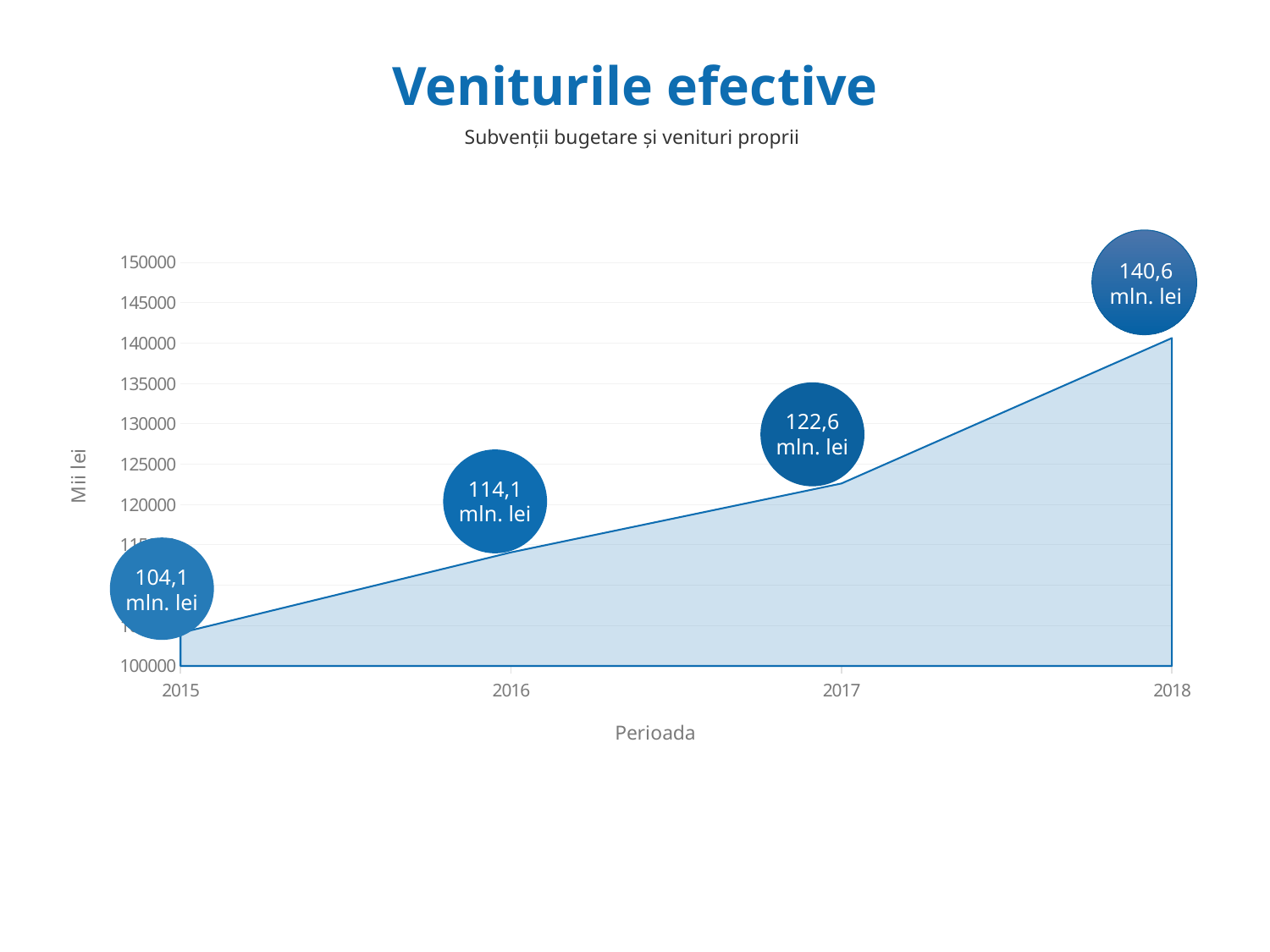
Is the value for 2017 greater or less than 120000 on the y axis? greater What is the value shown for 2018? 140,6 mln. lei Which year has the lowest value? 2015 Which is larger, the value for 2016 or the value for 2017? 2017 What is the difference between the 2017 value and the 2016 value? 8,5 mln. lei What is the difference between the 2018 value and the 2015 value? 36,5 mln. lei What is the value shown for 2015? 104,1 mln. lei How many years are plotted on the x axis? 4 Which year has the highest value? 2018 What is the value shown for 2016? 114,1 mln. lei What is the value shown for 2017? 122,6 mln. lei Do the values rise or fall from 2015 to 2018? rise